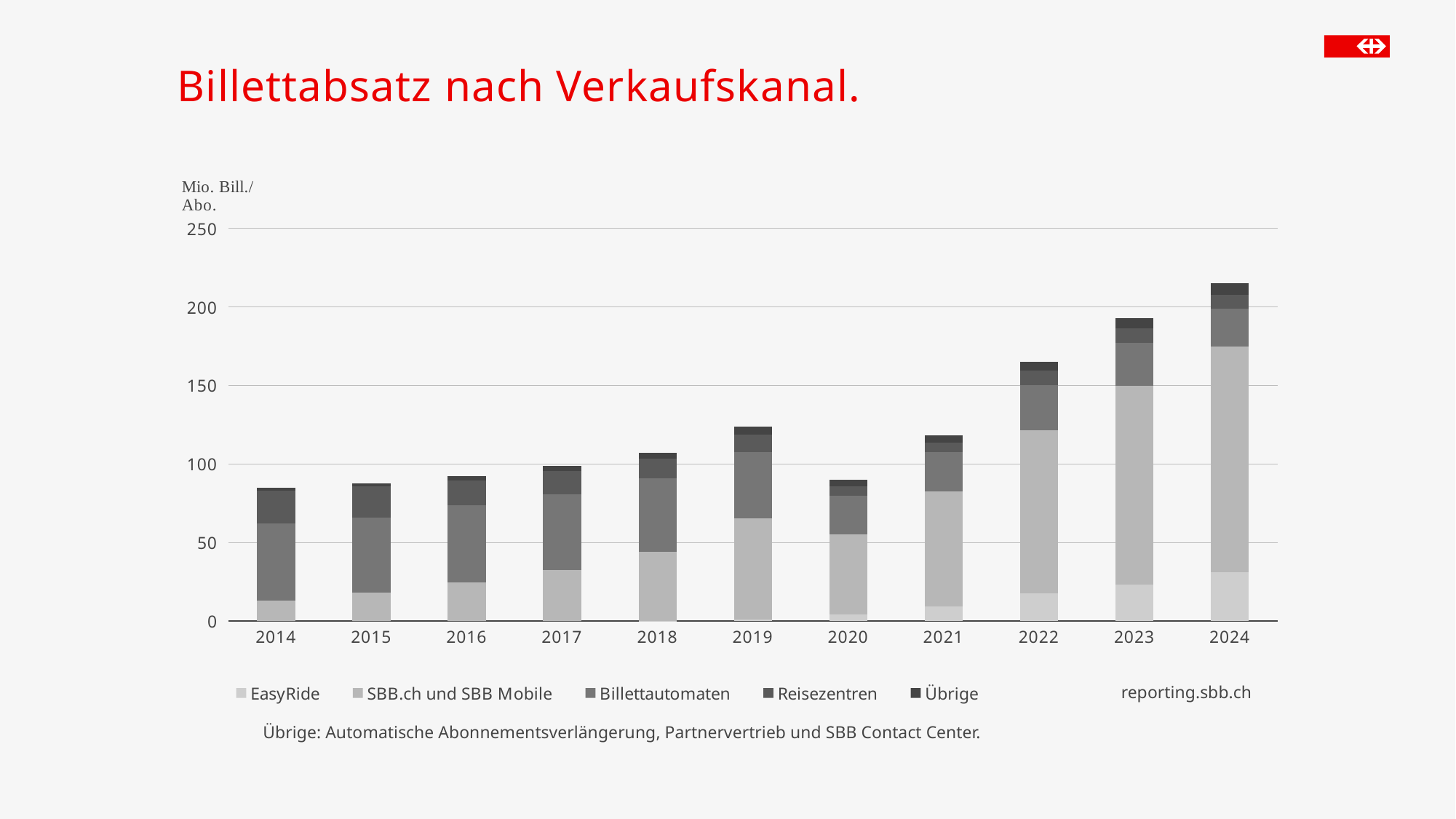
Is the total for 2024 greater or less than 200? greater How many series does the legend of the chart list? 5 Is the total for 2022 greater or less than 150? greater What unit is shown on the y axis of the chart? Mio. Bill./Abo. Which year has the highest total bar in the chart? 2024 What kind of chart is shown on the slide? Stacked bar chart Is the total for 2020 greater or less than 100? less How many years are shown on the x axis of the chart? 11 Do the total bars generally rise or fall from 2014 to 2024? rise What is the title of the chart on the slide? Billettabsatz nach Verkaufskanal. Which year has the larger total bar, 2019 or 2020? 2019